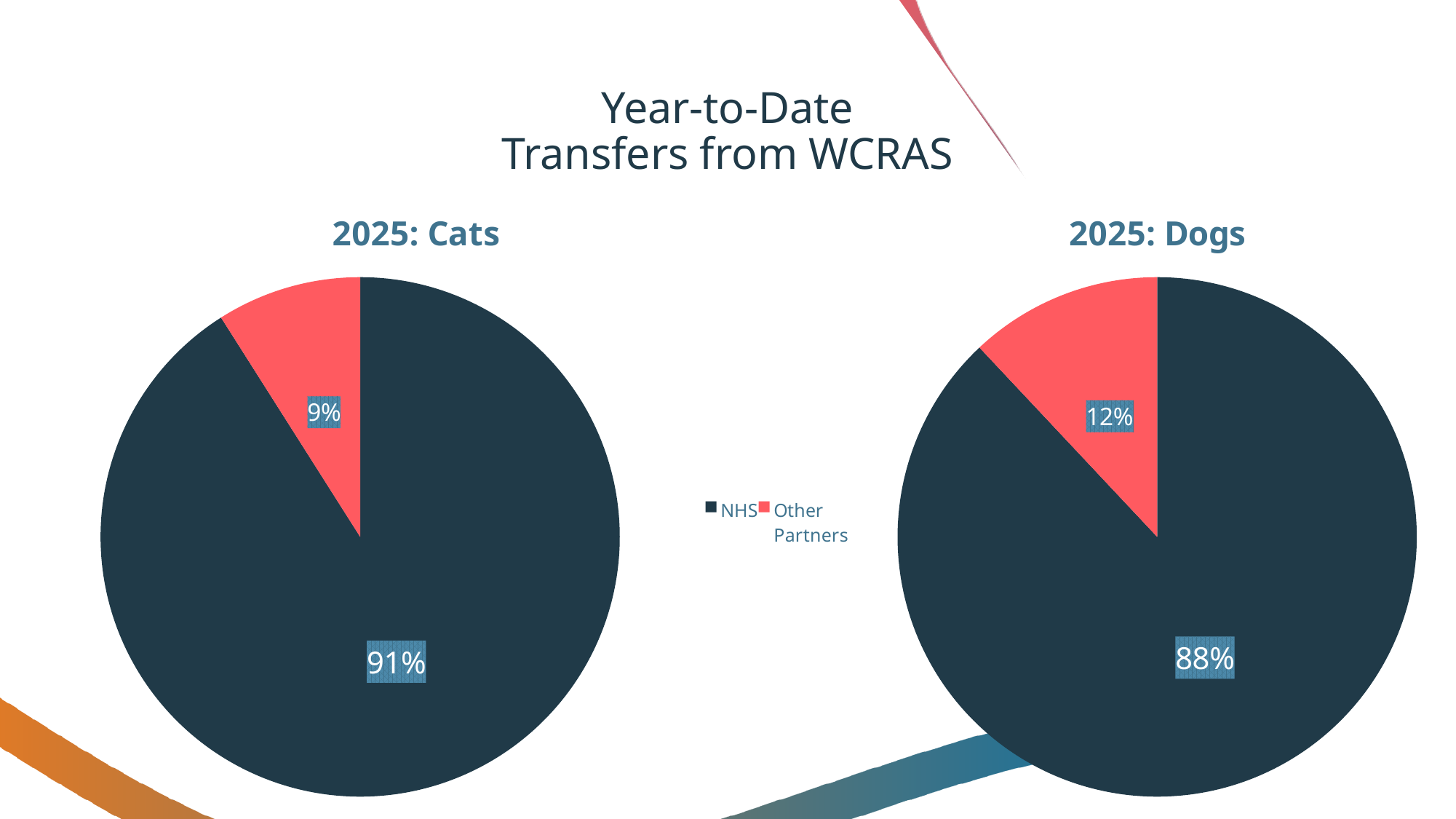
In the '2025: Cats' chart, what share of transfers went to NHS? 91% In the '2025: Cats' chart, what is the difference between the NHS share and the Other Partners share? 82% In the '2025: Cats' chart, what share of transfers went to Other Partners? 9% What type of chart is the '2025: Cats' chart? Pie chart What is the main title of the slide above the two charts? Year-to-Date Transfers from WCRAS How many categories does the legend list? 2 Which chart shows a larger share for Other Partners, '2025: Cats' or '2025: Dogs'? 2025: Dogs In the '2025: Cats' chart, which category has the largest slice? NHS In the '2025: Dogs' chart, what is the difference between the NHS share and the Other Partners share? 76% In the '2025: Dogs' chart, what share of transfers went to Other Partners? 12% In the '2025: Dogs' chart, which category has the smallest slice? Other Partners In the '2025: Dogs' chart, what share of transfers went to NHS? 88%